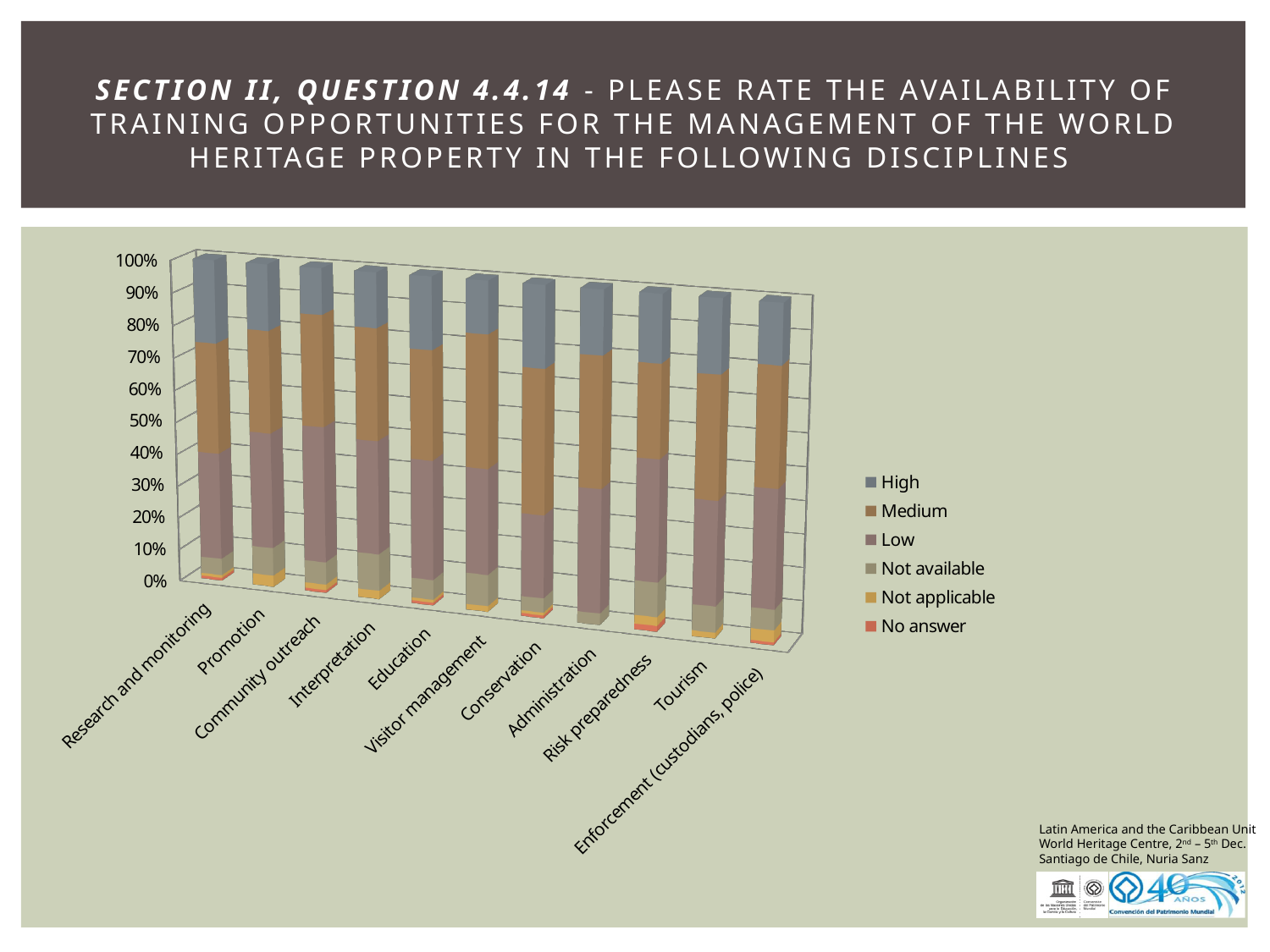
Which series is listed last in the chart legend? No answer Which discipline is the first category on the x axis? Research and monitoring Is the 'Low' share for Administration greater or less than 10%? greater What is the highest value shown on the vertical axis of the chart? 100% Is the 'High' share for Conservation greater or less than 50%? less How many series does the chart legend list? 6 Is the 'Medium' share for Conservation greater or less than 20%? greater How many disciplines (categories) are shown on the x axis of the chart? 11 What kind of chart is shown on the slide? Stacked bar chart